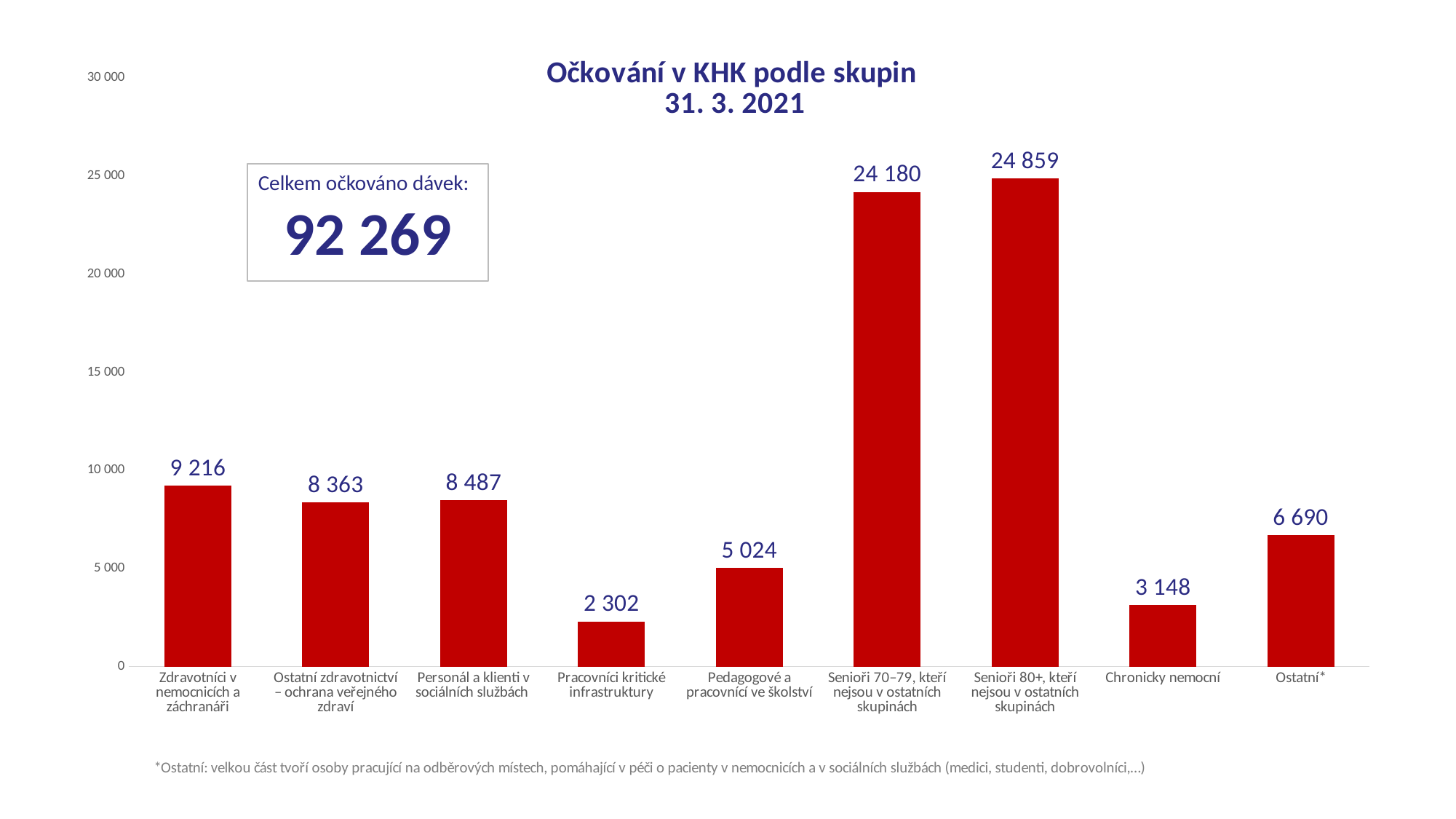
Which is larger: the value for Personál a klienti v sociálních službách or for Ostatní zdravotnictví – ochrana veřejného zdraví? Personál a klienti v sociálních službách What is the value for Chronicky nemocní? 3 148 What kind of chart is shown on the slide? bar chart Is the value for Ostatní* greater or less than 5 000? greater Which category has the lowest value? Pracovníci kritické infrastruktury What is the difference between the values for Zdravotníci v nemocnicích a záchranáři and Ostatní zdravotnictví – ochrana veřejného zdraví? 853 What is the difference between the values for Senioři 80+ and Senioři 70–79? 679 What is the value for Pedagogové a pracovníci ve školství? 5 024 Which category has the highest value? Senioři 80+, kteří nejsou v ostatních skupinách What is the value for Zdravotníci v nemocnicích a záchranáři? 9 216 How many categories are shown on the chart? 9 What total number of doses (Celkem očkováno dávek) is shown in the box on the slide? 92 269